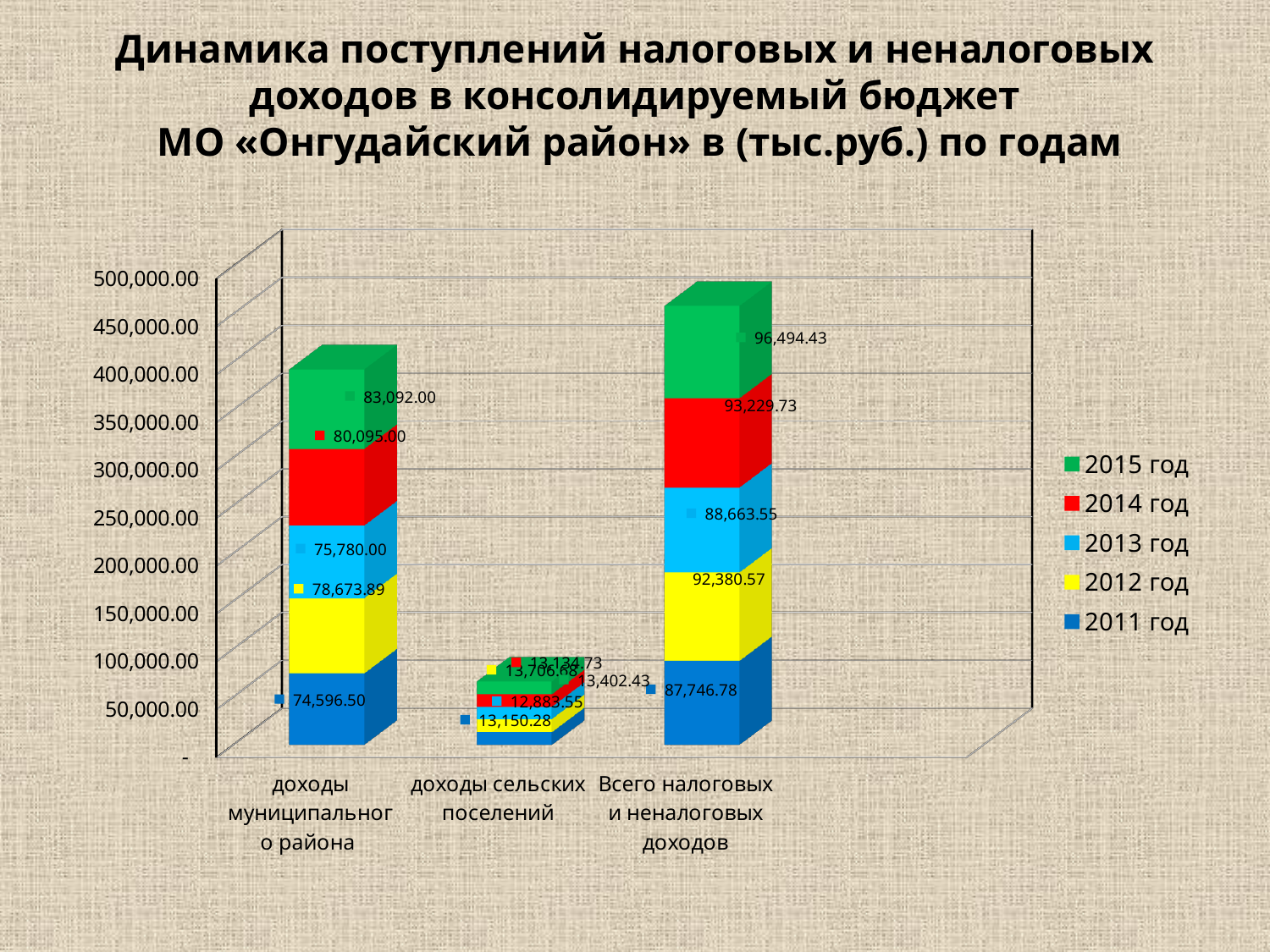
What is the value for 2015 год in the доходы муниципального района bar? 83,092.00 What is the difference between the 2015 год values for Всего налоговых и неналоговых доходов and доходы муниципального района? 13,402.43 Which year has the lowest value in the доходы муниципального района bar? 2011 год What is the value for 2013 год in the Всего налоговых и неналоговых доходов bar? 88,663.55 How many series does the legend list? 5 What kind of chart is shown on the slide? stacked bar chart Is the total height of the Всего налоговых и неналоговых доходов bar greater or less than 400,000.00? greater How many categories are shown on the x axis? 3 Which is larger: the 2014 год value for доходы муниципального района or the 2013 год value for доходы муниципального района? 2014 год What is the value for 2011 год in the Всего налоговых и неналоговых доходов bar? 87,746.78 Which year has the highest value in the Всего налоговых и неналоговых доходов bar? 2015 год What is the value for 2012 год in the доходы муниципального района bar? 78,673.89